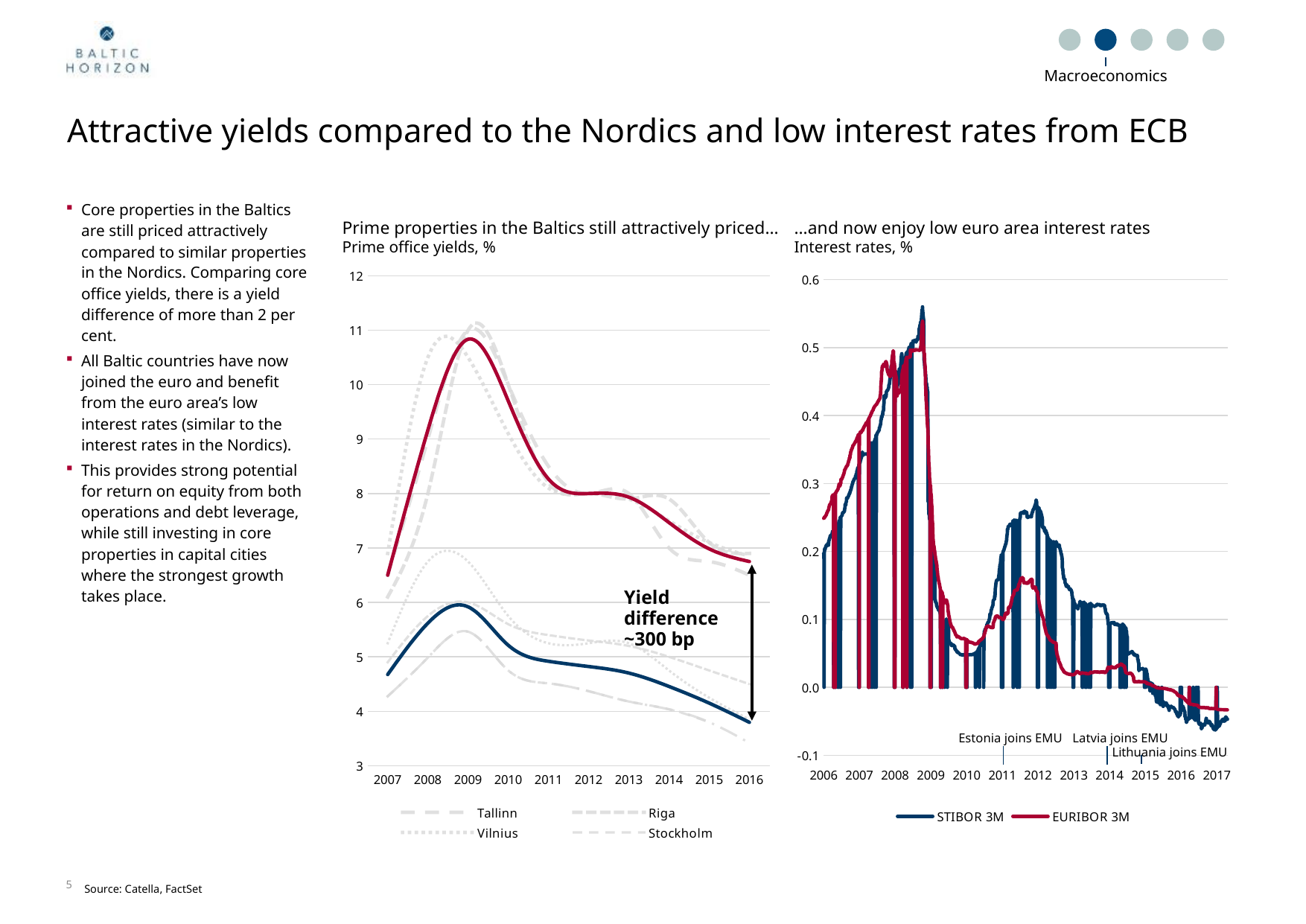
On the right chart (Interest rates, %), is the peak value of STIBOR 3M in 2009 greater or less than 0.5? greater What kind of chart is the left chart titled 'Prime properties in the Baltics still attractively priced...'? line chart On the left chart (Prime office yields, %), what yield difference is annotated between the two solid lines in 2016? ~300 bp How many series does the legend of the right chart (Interest rates, %) list? 2 On the left chart (Prime office yields, %), is the value of the red solid line in 2009 greater or less than 10? greater How many series does the legend of the left chart (Prime office yields, %) list? 4 On the right chart (Interest rates, %), which series is higher in 2012, STIBOR 3M or EURIBOR 3M? STIBOR 3M On the left chart (Prime office yields, %), does the red solid line rise or fall between 2009 and 2016? fall On the left chart (Prime office yields, %), how many years are labelled on the x axis? 10 What kind of chart is the right chart titled '...and now enjoy low euro area interest rates'? line chart On the left chart (Prime office yields, %), is the value of the blue solid line in 2009 greater or less than 7? less